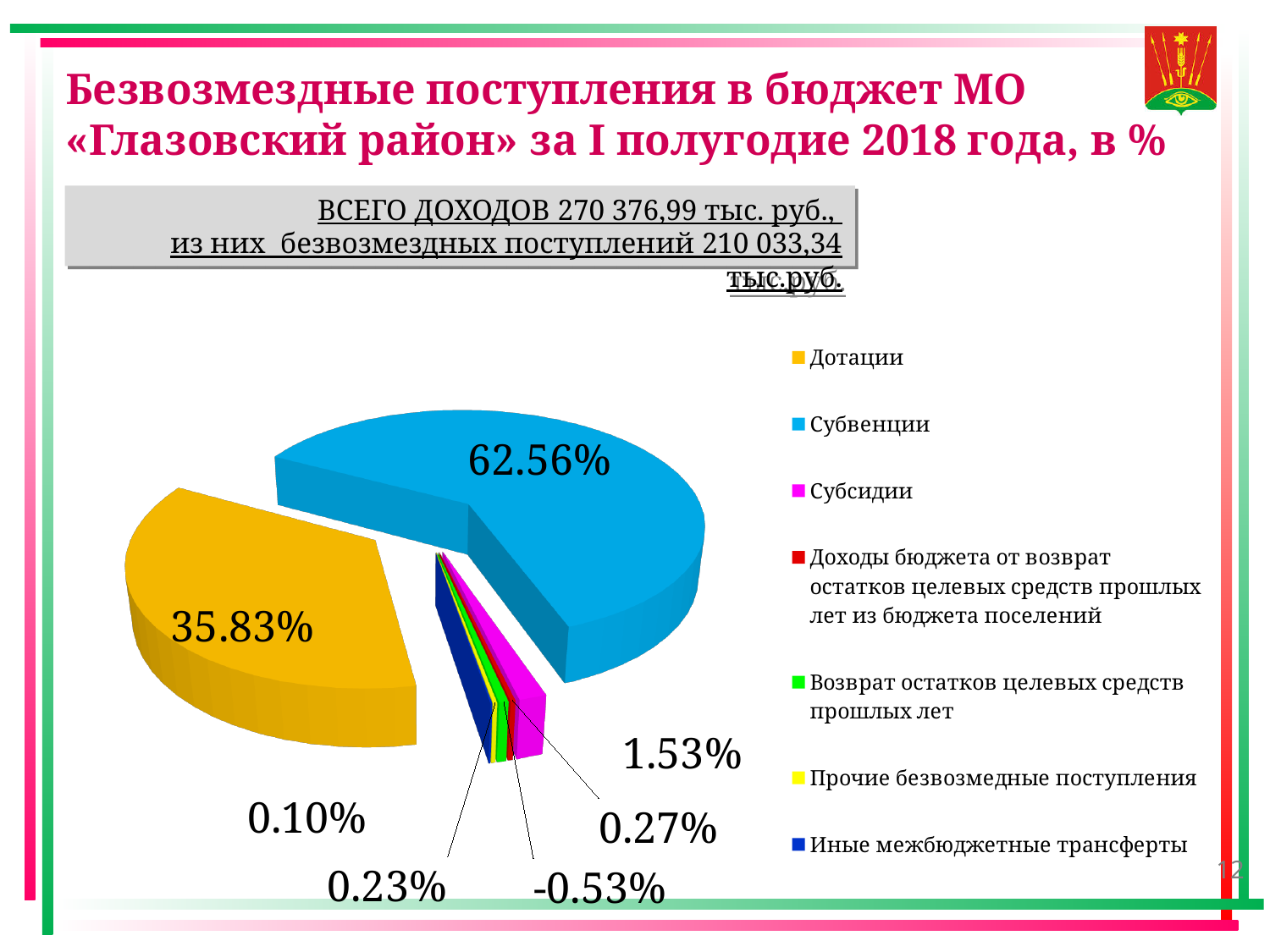
What kind of chart is shown on the slide? pie chart What colour is the slice for Субвенции? blue What is the smallest percentage value labelled on the pie chart? -0.53% Which category has the largest share of the pie? Субвенции What is the total of all incomes stated in the text box above the chart? 270 376,99 тыс. руб. How many categories does the legend of the pie chart list? 7 Is the share of Субвенции greater or less than 50%? greater What share of the pie does Субвенции hold? 62.56% What is the difference between the shares of Субвенции and Дотации? 26.73% Which is larger, the share of Дотации or the share of Субсидии? Дотации What share of the pie does Субсидии hold? 1.53% What share of the pie does Дотации hold? 35.83%